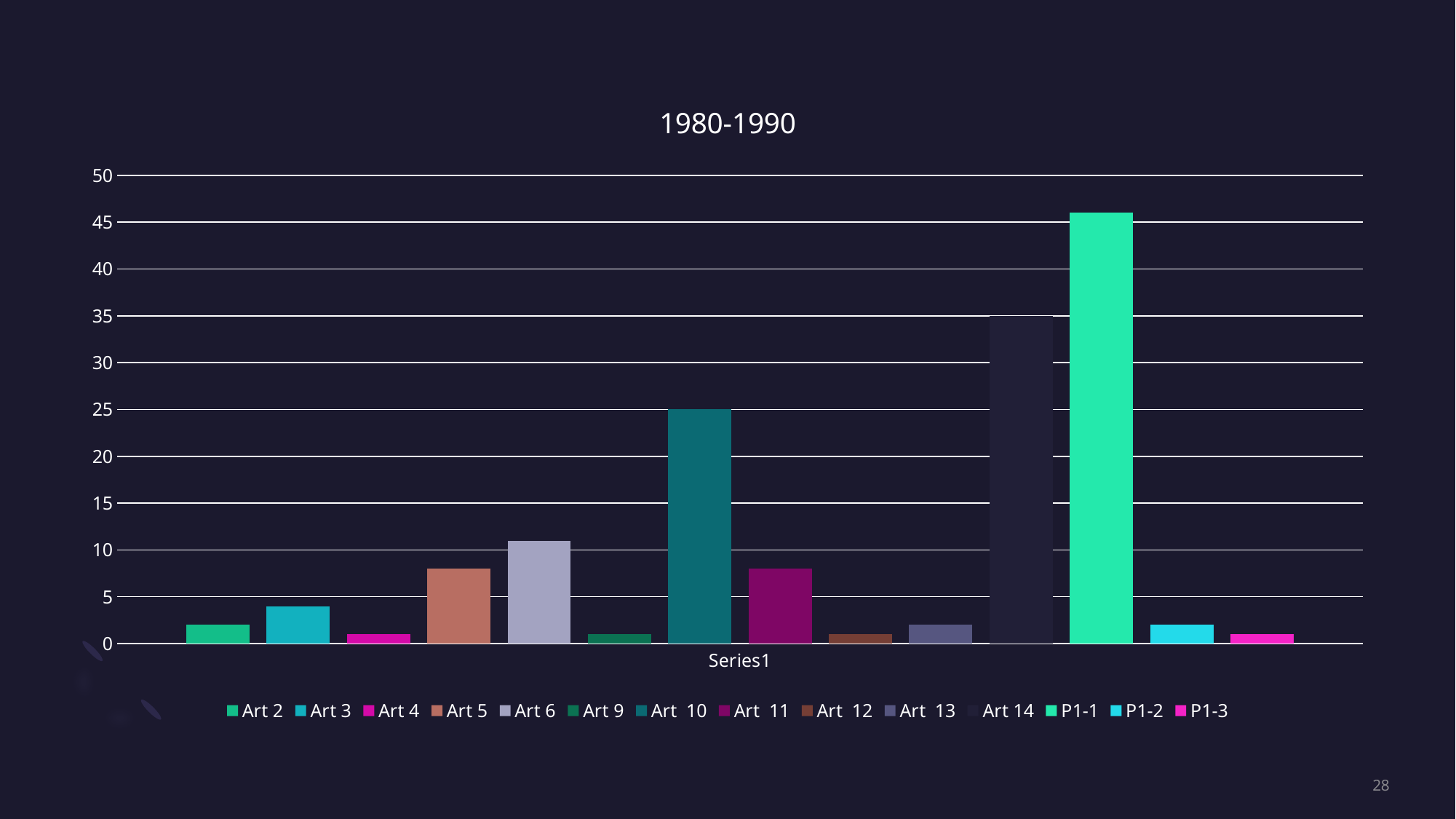
What is the label of the category on the x axis? Series1 What is the value for Art 10? 25 What is the value for Art 14? 35 What kind of chart is shown on the slide? bar chart Which series has the highest value? P1-1 How many categories are shown on the x axis? 1 Is the value for Art 5 greater or less than 10? less What is the title of the chart? 1980-1990 Which is larger, the value for Art 10 or the value for Art 6? Art 10 How many series does the legend list? 14 What is the difference between the values for Art 14 and Art 10? 10 Is the value for P1-1 greater or less than 40? greater